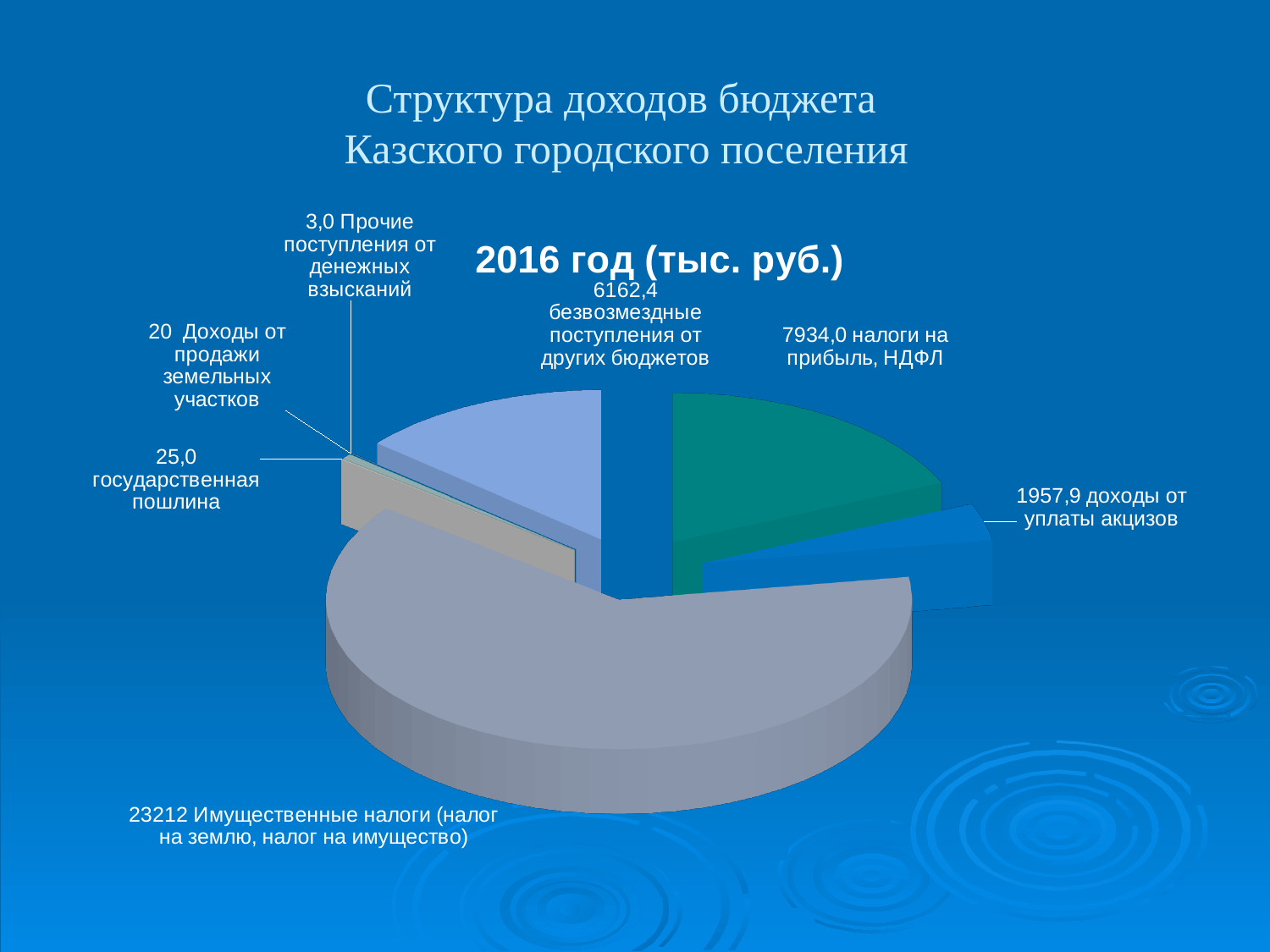
Which is larger: доходы от продажи земельных участков or государственная пошлина? государственная пошлина What is the title of the chart? 2016 год (тыс. руб.) What type of chart is shown on the slide? pie chart What is the difference between Имущественные налоги and налоги на прибыль, НДФЛ? 15278 Which category has the smallest value? Прочие поступления от денежных взысканий What is the value for государственная пошлина? 25,0 Which category has the largest value? Имущественные налоги (налог на землю, налог на имущество) What is the value for доходы от уплаты акцизов? 1957,9 What is the difference between налоги на прибыль, НДФЛ and безвозмездные поступления от других бюджетов? 1771,6 What is the value for налоги на прибыль, НДФЛ? 7934,0 What is the value for безвозмездные поступления от других бюджетов? 6162,4